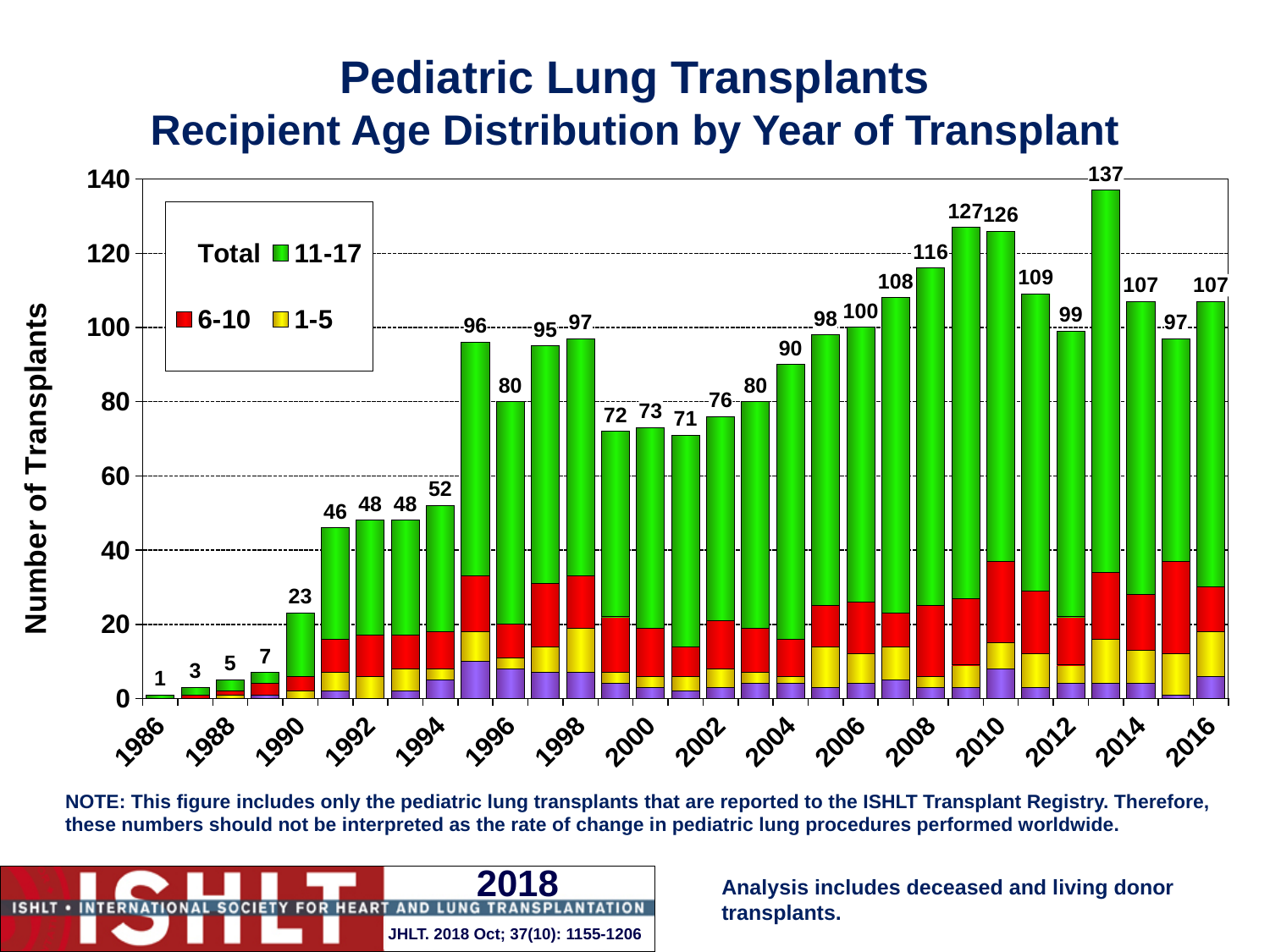
Do the totals generally rise or fall from 1986 to 1995? Rise What is the total number of transplants shown for 1990? 23 What is the total number of pediatric lung transplants shown for 2013? 137 Which year has the highest total number of transplants? 2013 What is the difference between the total for 2009 and the total for 2012? 28 How many years (bars) are plotted on the chart? 31 Which year has a larger total, 1995 or 1996? 1995 What is the total number of transplants shown for 2008? 116 Which colour represents the 11-17 age group in the legend? Green Which year has the lowest total number of transplants? 1986 What kind of chart is shown on the slide? Stacked bar chart Is the total for 2004 greater or less than 80? greater